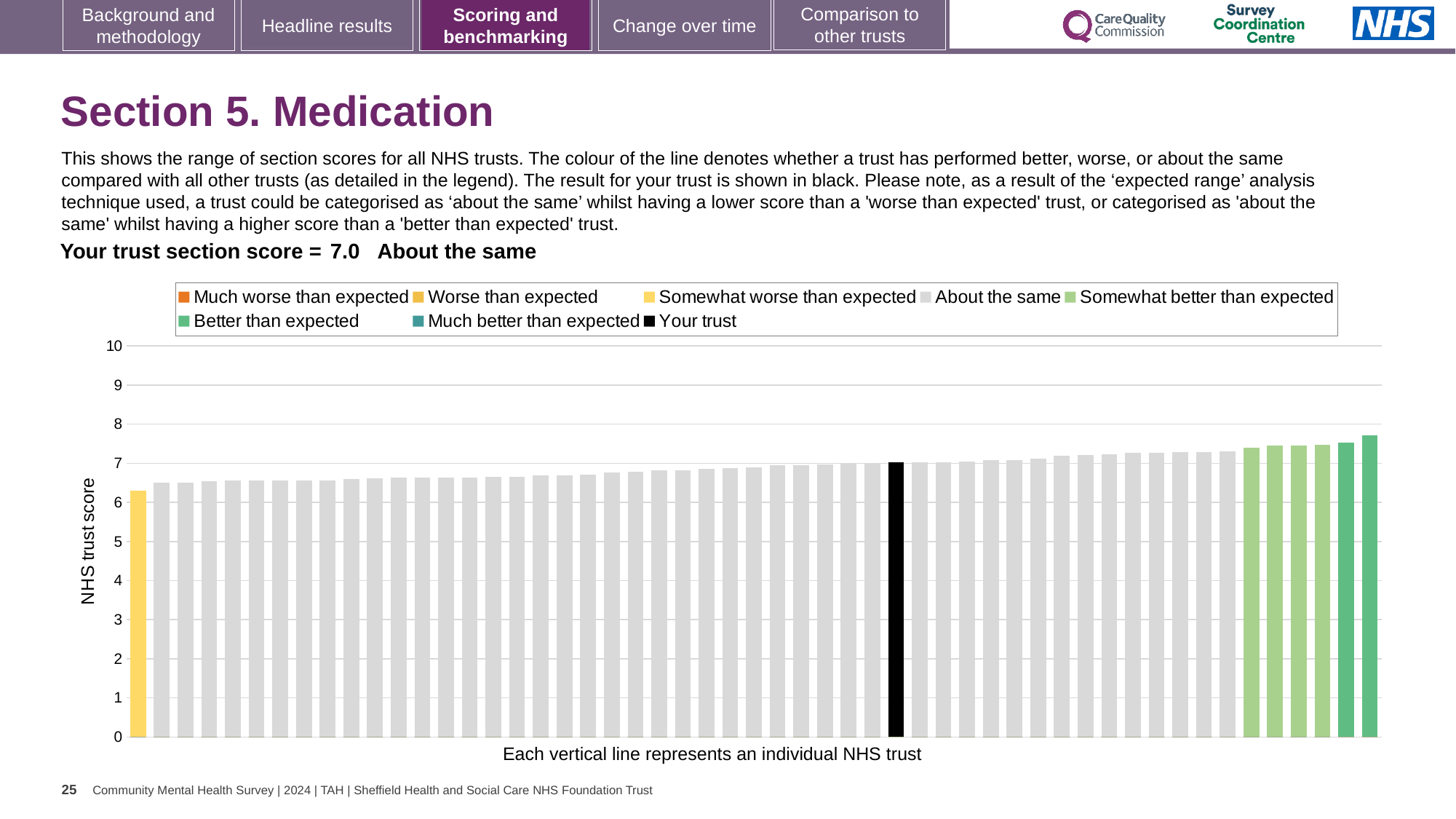
Is the value of the highest (rightmost) bar greater or less than 8? less Do the NHS trust scores rise or fall from left to right along the x axis? rise What is the label on the vertical axis of the chart? NHS trust score Which bar is higher: the black bar for your trust or the yellow leftmost bar? the black bar for your trust What is the section score for your trust shown on the slide? 7.0 What kind of chart is shown on the slide? bar chart Is the value of the lowest (leftmost) bar greater or less than 7? less What colour is the bar representing your trust? black How is your trust's section score categorised compared with other trusts? About the same How many entries does the chart legend list? 8 Is the value of the highest (rightmost) bar greater or less than 7? greater How many bars are coloured yellow (Worse than expected)? 1